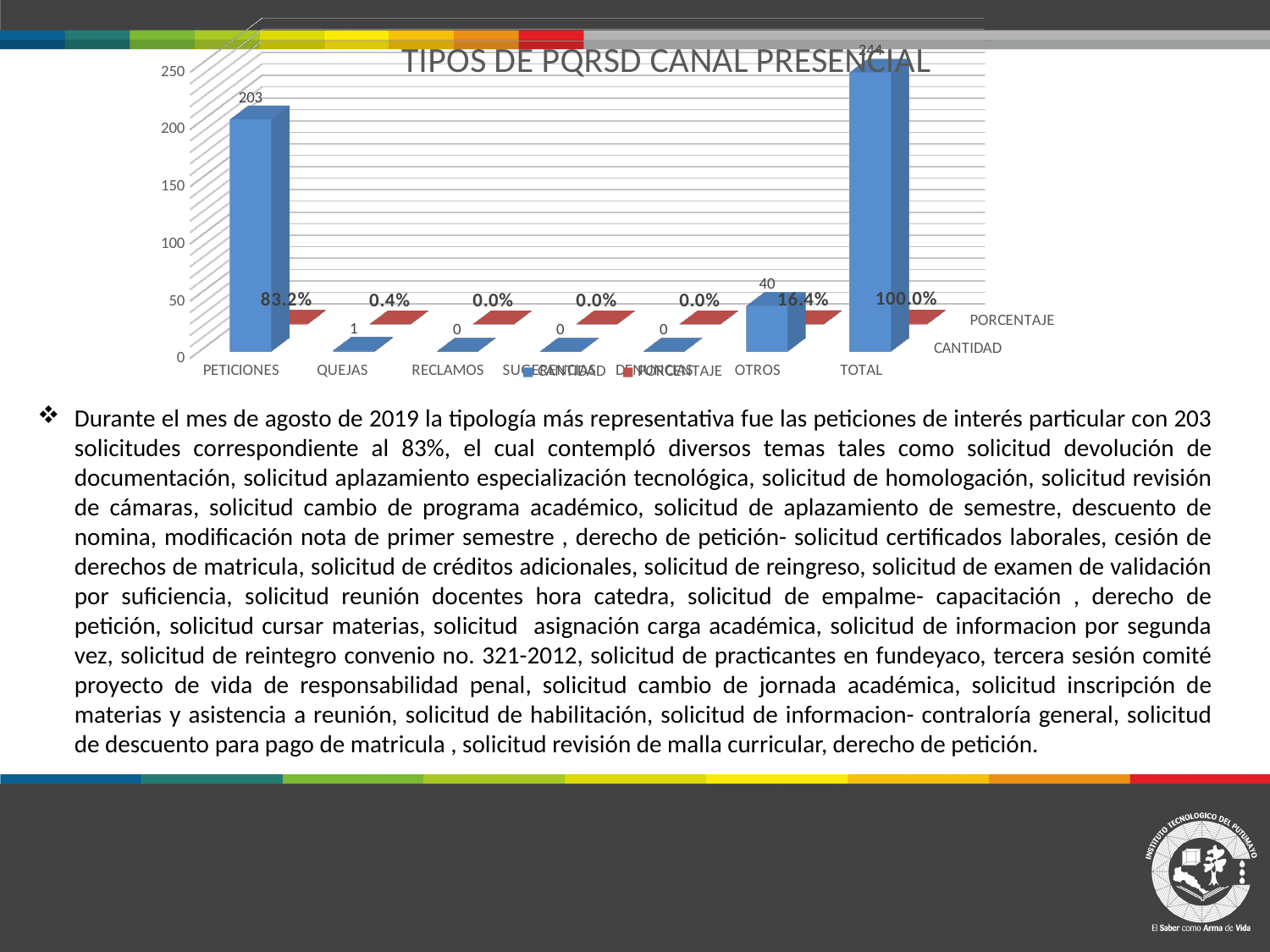
What is the PORCENTAJE value for OTROS? 16.4% What is the title of the chart? TIPOS DE PQRSD CANAL PRESENCIAL What is the difference between the CANTIDAD values for PETICIONES and OTROS? 163 What is the CANTIDAD value for PETICIONES? 203 What is the PORCENTAJE value for PETICIONES? 83.2% Is the CANTIDAD value for PETICIONES greater or less than 200? greater Excluding TOTAL, which category has the highest CANTIDAD value? PETICIONES What is the CANTIDAD value for QUEJAS? 1 How many series does the chart legend list? 2 What type of chart is shown on the slide? bar chart What is the CANTIDAD value for OTROS? 40 What is the PORCENTAJE value for QUEJAS? 0.4%